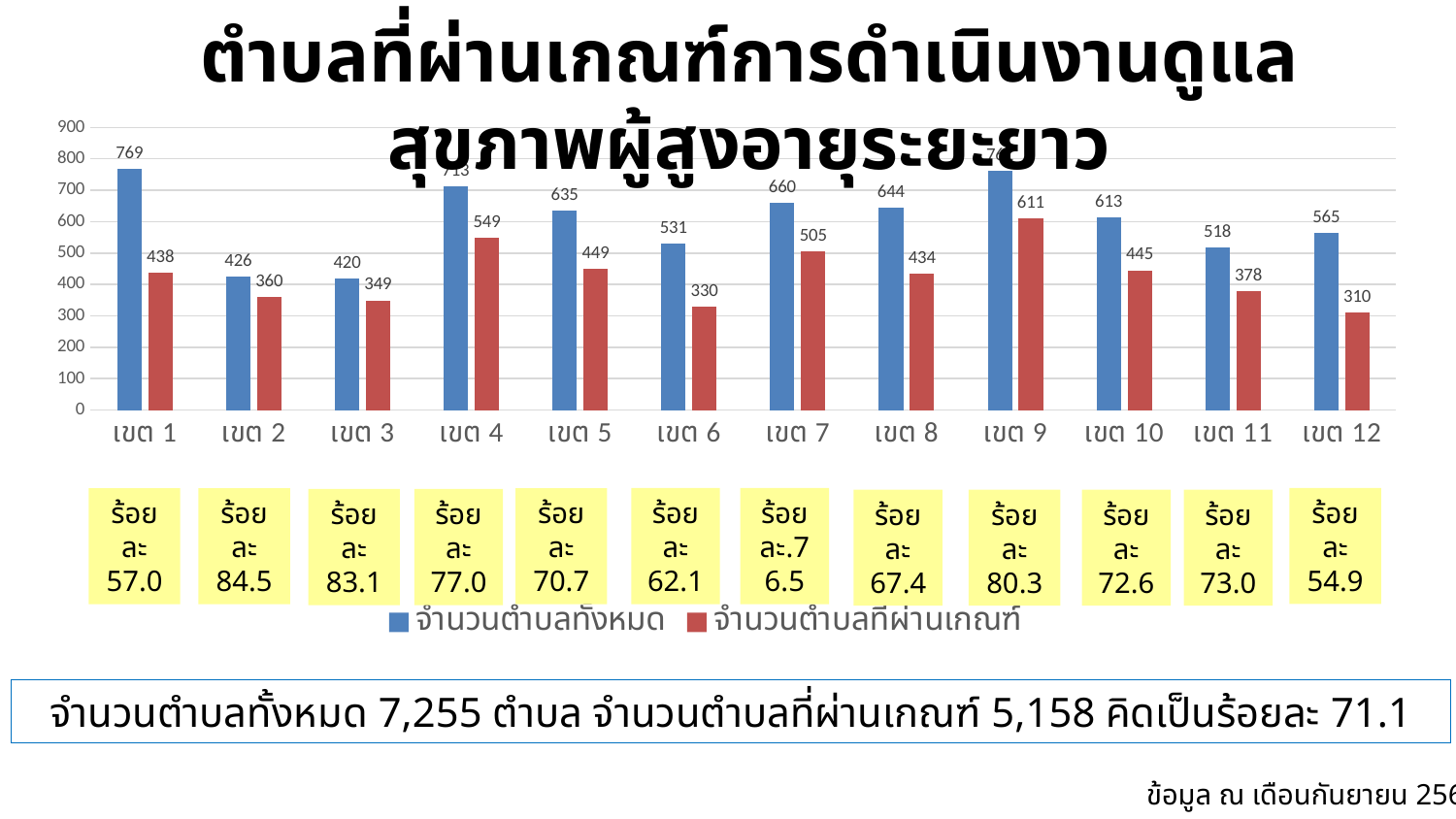
What kind of chart is shown on the slide? bar chart How many เขต categories are shown on the x axis of the chart? 12 Is the value of จำนวนตำบลทั้งหมด for เขต 9 greater or less than 700? greater What is the value of จำนวนตำบลทั้งหมด for เขต 1? 769 What colour represents จำนวนตำบลที่ผ่านเกณฑ์ in the chart? red How many series does the chart legend list? 2 What is the value of จำนวนตำบลที่ผ่านเกณฑ์ for เขต 6? 330 Which เขต has the lowest value for จำนวนตำบลที่ผ่านเกณฑ์? เขต 12 Which has a larger value for จำนวนตำบลที่ผ่านเกณฑ์, เขต 7 or เขต 8? เขต 7 What is the difference between จำนวนตำบลทั้งหมด and จำนวนตำบลที่ผ่านเกณฑ์ for เขต 1? 331 What is the value of จำนวนตำบลที่ผ่านเกณฑ์ for เขต 10? 445 Which เขต has the highest value for จำนวนตำบลที่ผ่านเกณฑ์? เขต 9